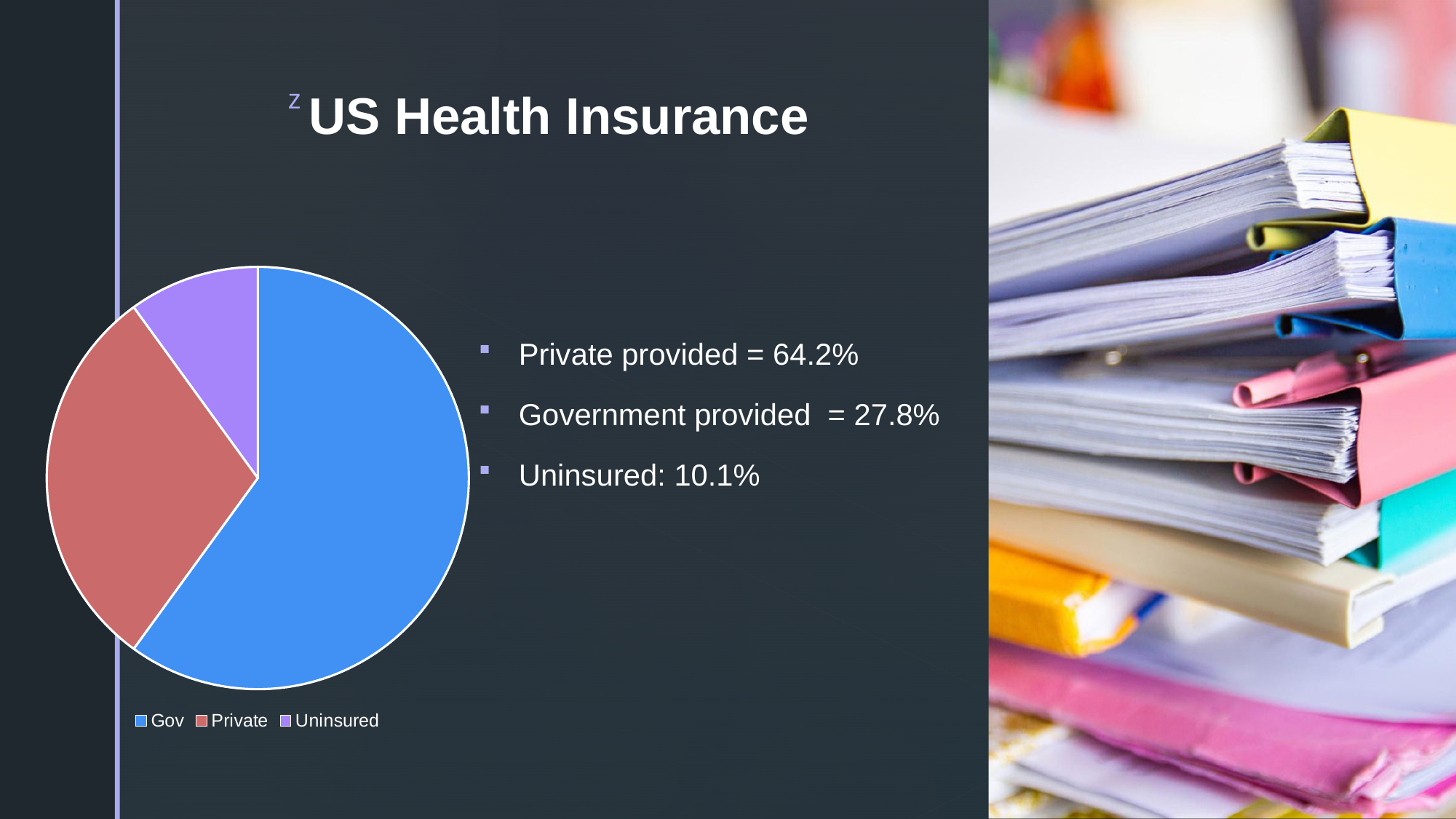
What kind of chart is shown on the slide? Pie chart What colour is the Private slice in the pie chart? Red Which slice is larger in the pie chart, Private or Uninsured? Private What categories are listed in the pie chart's legend? Gov, Private, Uninsured Is the Gov slice more or less than half of the pie? more Which category has the smallest slice in the pie chart? Uninsured Which category has the largest slice in the pie chart? Gov How many slices does the pie chart have? 3 Which slice is larger in the pie chart, Gov or Private? Gov